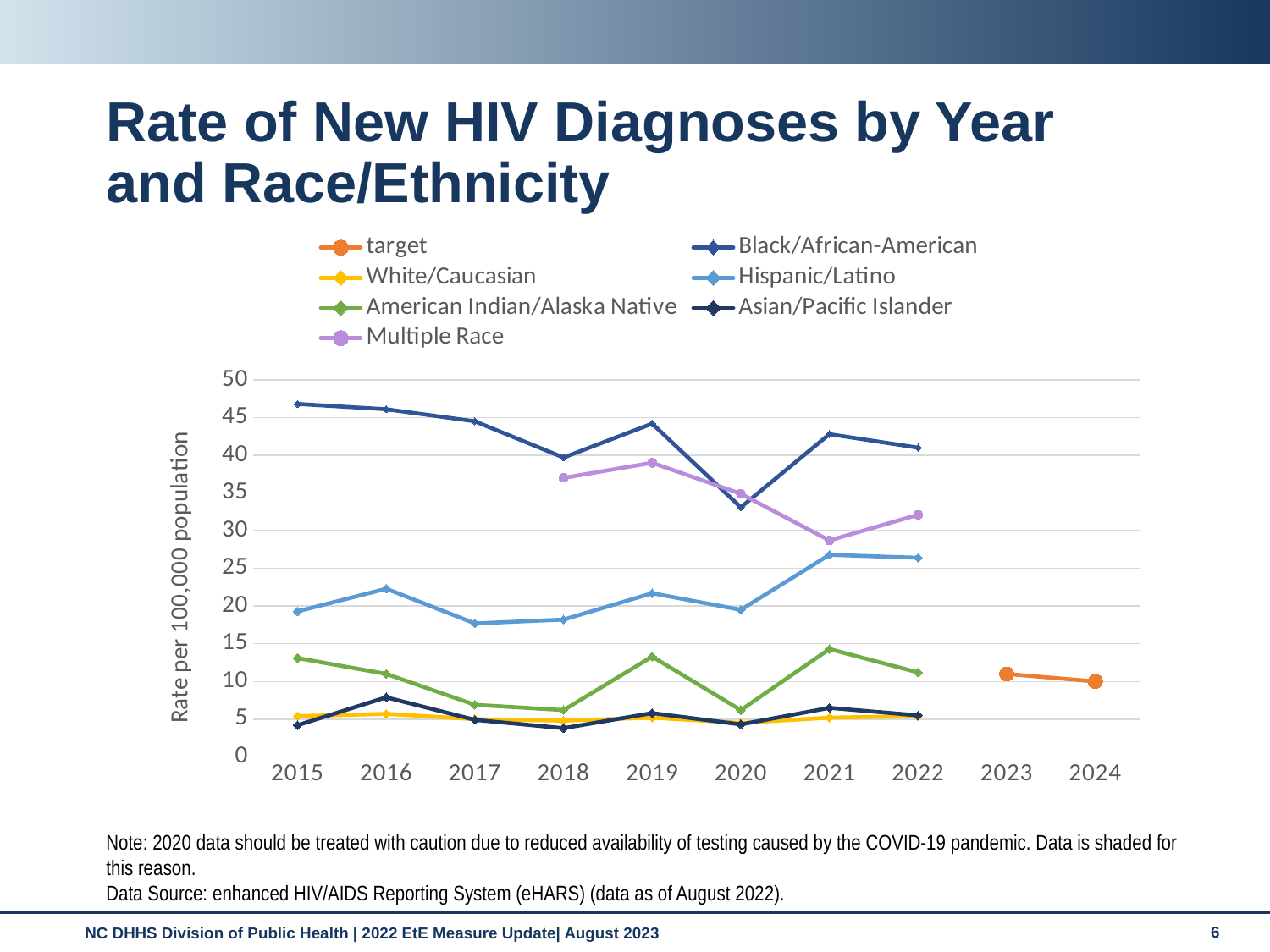
Is the value for Black/African-American in 2020 greater or less than 35? less What kind of chart is shown on the slide? line chart Which race/ethnicity series has the highest rate in 2015? Black/African-American Is the value for Multiple Race in 2021 greater or less than 30? less In 2022, which is larger: the Multiple Race rate or the Hispanic/Latino rate? Multiple Race How many series does the legend list? 7 What is the label on the y axis? Rate per 100,000 population Is the value for Black/African-American in 2015 greater or less than 45? greater Does the Black/African-American rate rise or fall from 2015 to 2018? fall Does the Hispanic/Latino rate rise or fall from 2020 to 2021? rise How many years are shown on the x axis? 10